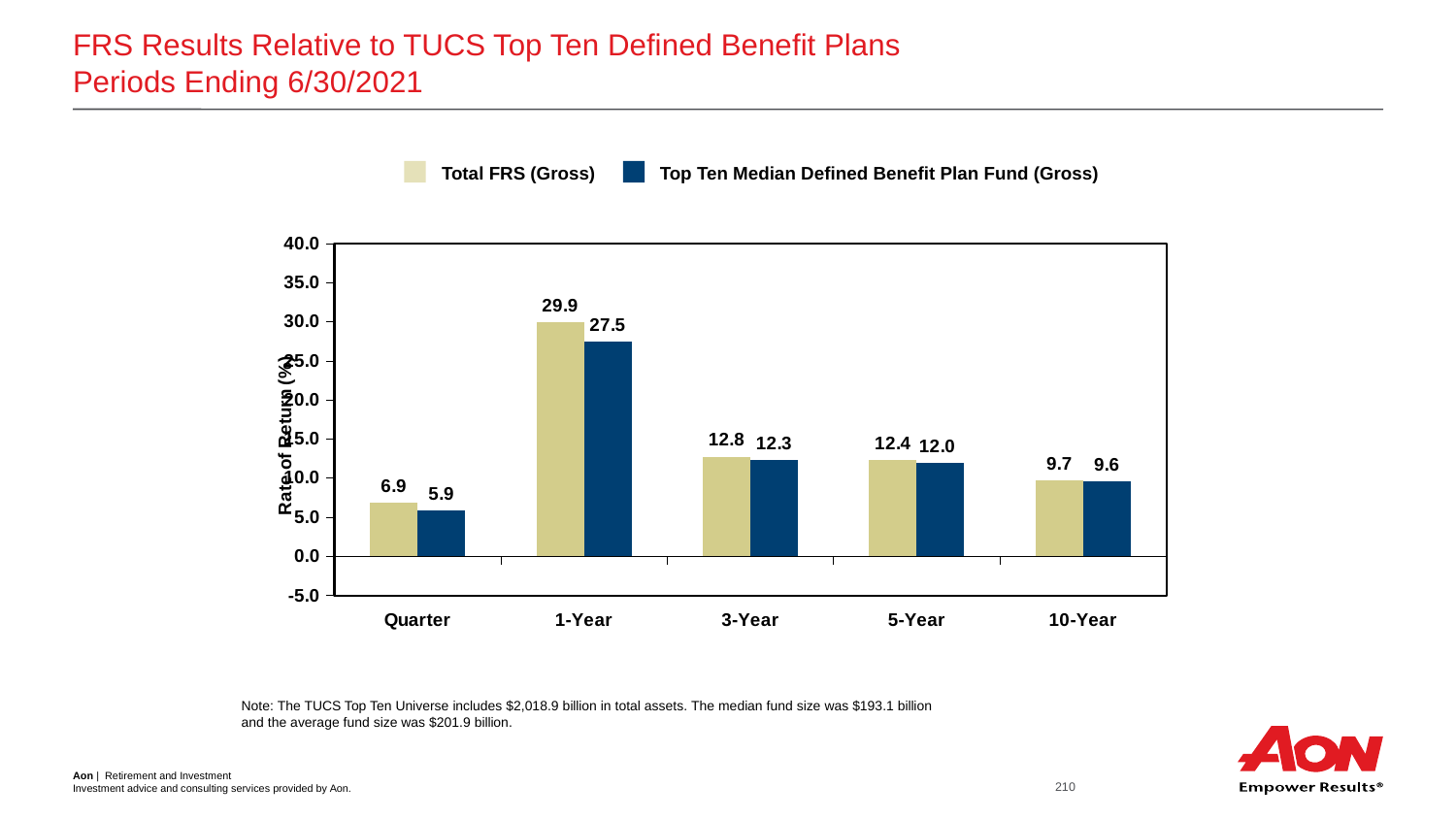
What is the Top Ten Median Defined Benefit Plan Fund (Gross) rate of return for the Quarter? 5.9 How many periods are shown on the x axis? 5 What is the Total FRS (Gross) rate of return for the 1-Year period? 29.9 How many series does the legend list? 2 What is the Total FRS (Gross) value for the 10-Year period? 9.7 For the 3-Year period, which is larger: Total FRS (Gross) or Top Ten Median Defined Benefit Plan Fund (Gross)? Total FRS (Gross) What is the label of the y axis? Rate of Return (%) What kind of chart is shown on the slide? Bar chart What is the difference between Total FRS (Gross) and Top Ten Median Defined Benefit Plan Fund (Gross) for the Quarter? 1.0 What is the difference between Total FRS (Gross) and Top Ten Median Defined Benefit Plan Fund (Gross) for the 1-Year period? 2.4 Which period has the highest Total FRS (Gross) rate of return? 1-Year Which period has the lowest Top Ten Median Defined Benefit Plan Fund (Gross) rate of return? Quarter